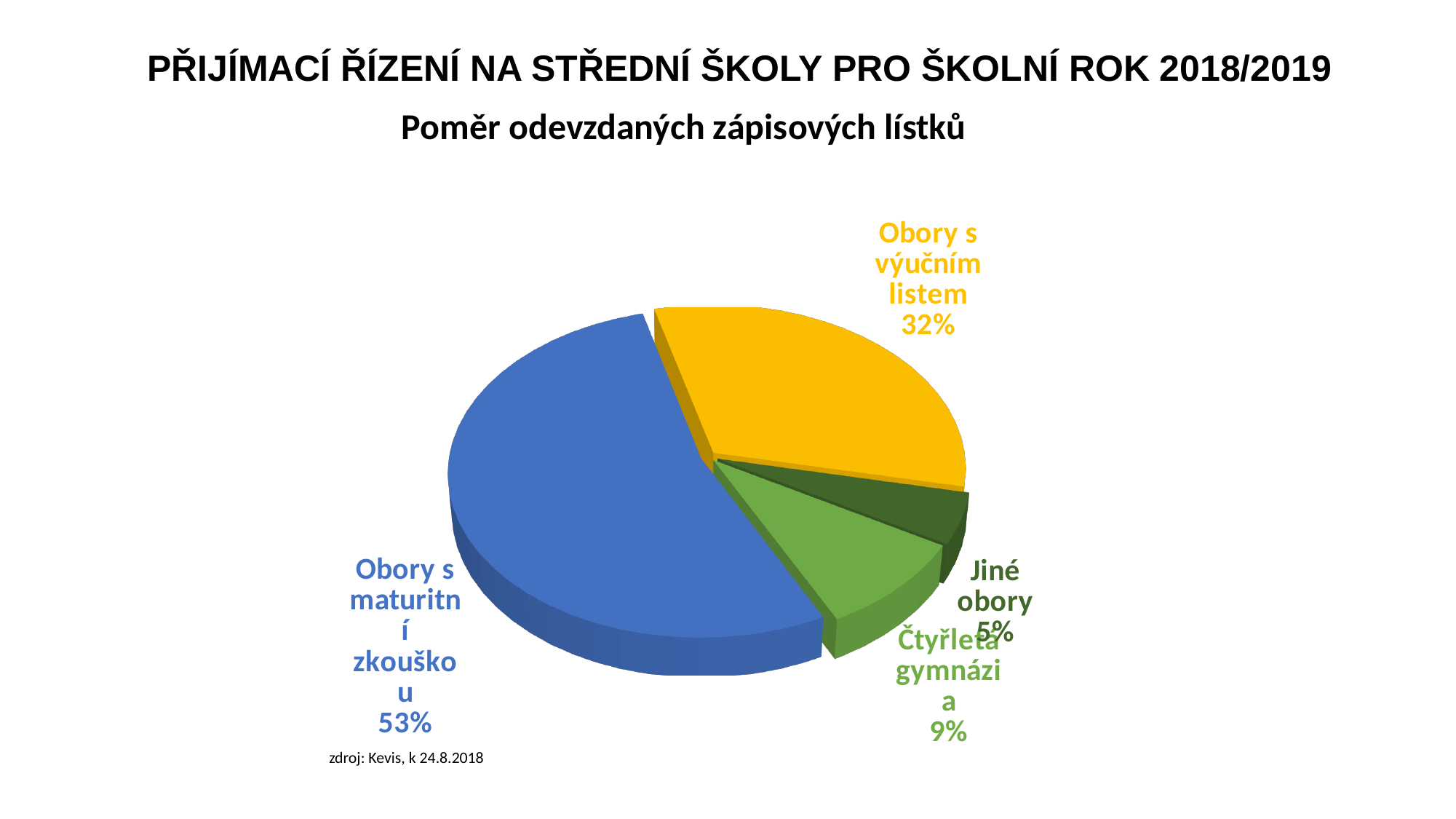
Which category has the largest slice of the pie? Obory s maturitní zkouškou How many categories are shown in the pie chart? 4 What share of the pie does "Obory s maturitní zkouškou" have? 53% What kind of chart is shown on the slide? Pie chart Which is larger, the share for "Čtyřletá gymnázia" or the share for "Jiné obory"? Čtyřletá gymnázia What share of the pie does "Obory s výučním listem" have? 32% What is the title of the chart? Poměr odevzdaných zápisových lístků What colour is the slice for "Obory s výučním listem"? Yellow What share of the pie does "Čtyřletá gymnázia" have? 9% What is the difference in percentage points between "Obory s maturitní zkouškou" and "Obory s výučním listem"? 21 percentage points Which category has the smallest slice of the pie? Jiné obory